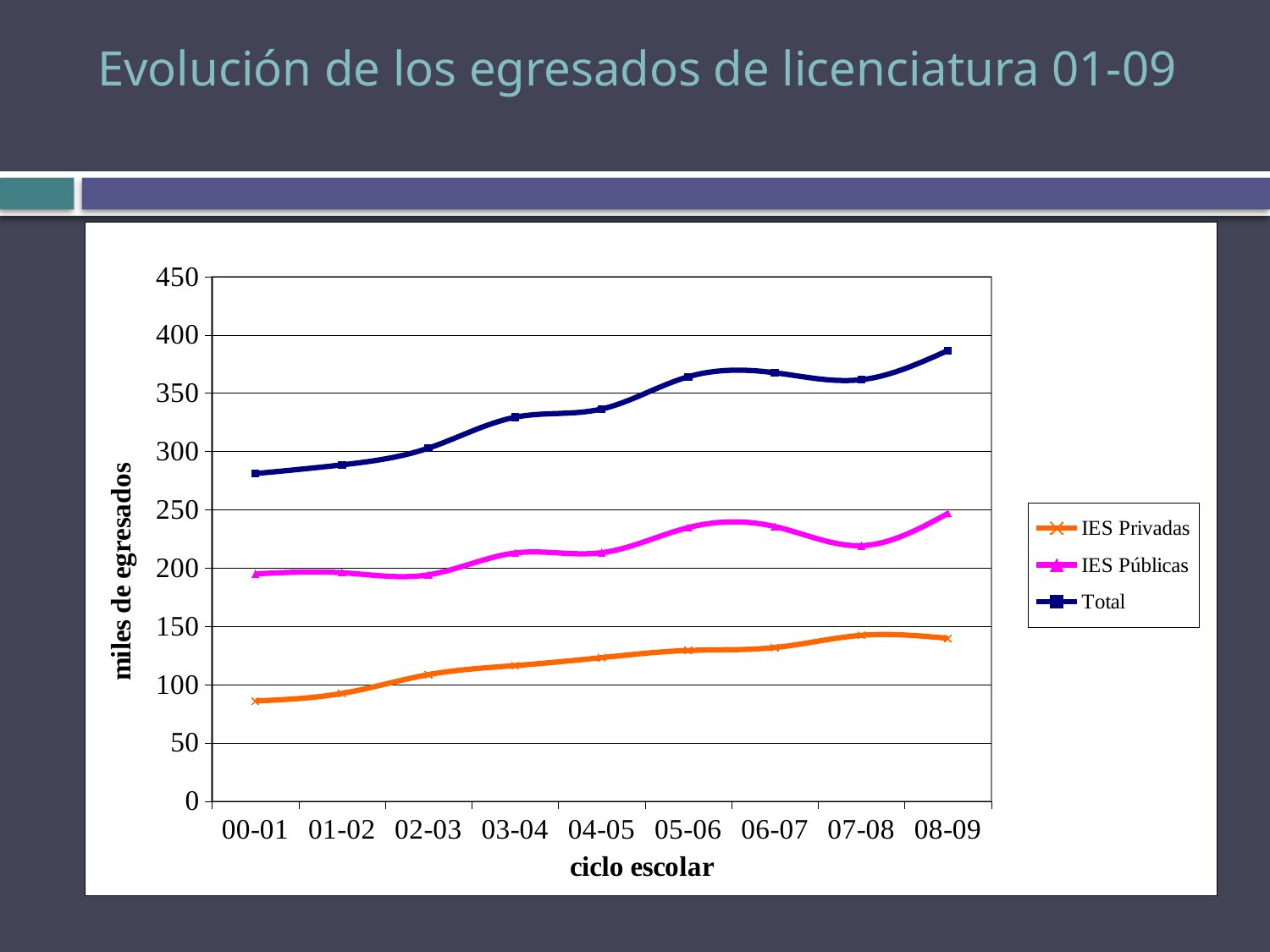
Which series is plotted with the dark blue line? Total In which school cycle is the Total series at its highest? 08-09 Is the Total value for 08-09 greater or less than 350? greater What kind of chart is shown on the slide? line chart Is the Total value for 00-01 greater or less than 300? less What is the label of the y axis? miles de egresados Does the Total series generally rise or fall from 00-01 to 08-09? rise How many series does the legend list? 3 In which school cycle is the IES Privadas series at its lowest? 00-01 In 04-05, which is larger: IES Públicas or IES Privadas? IES Públicas Is the IES Privadas value for 00-01 greater or less than 100? less How many school cycles (ciclos escolares) are plotted along the x axis? 9